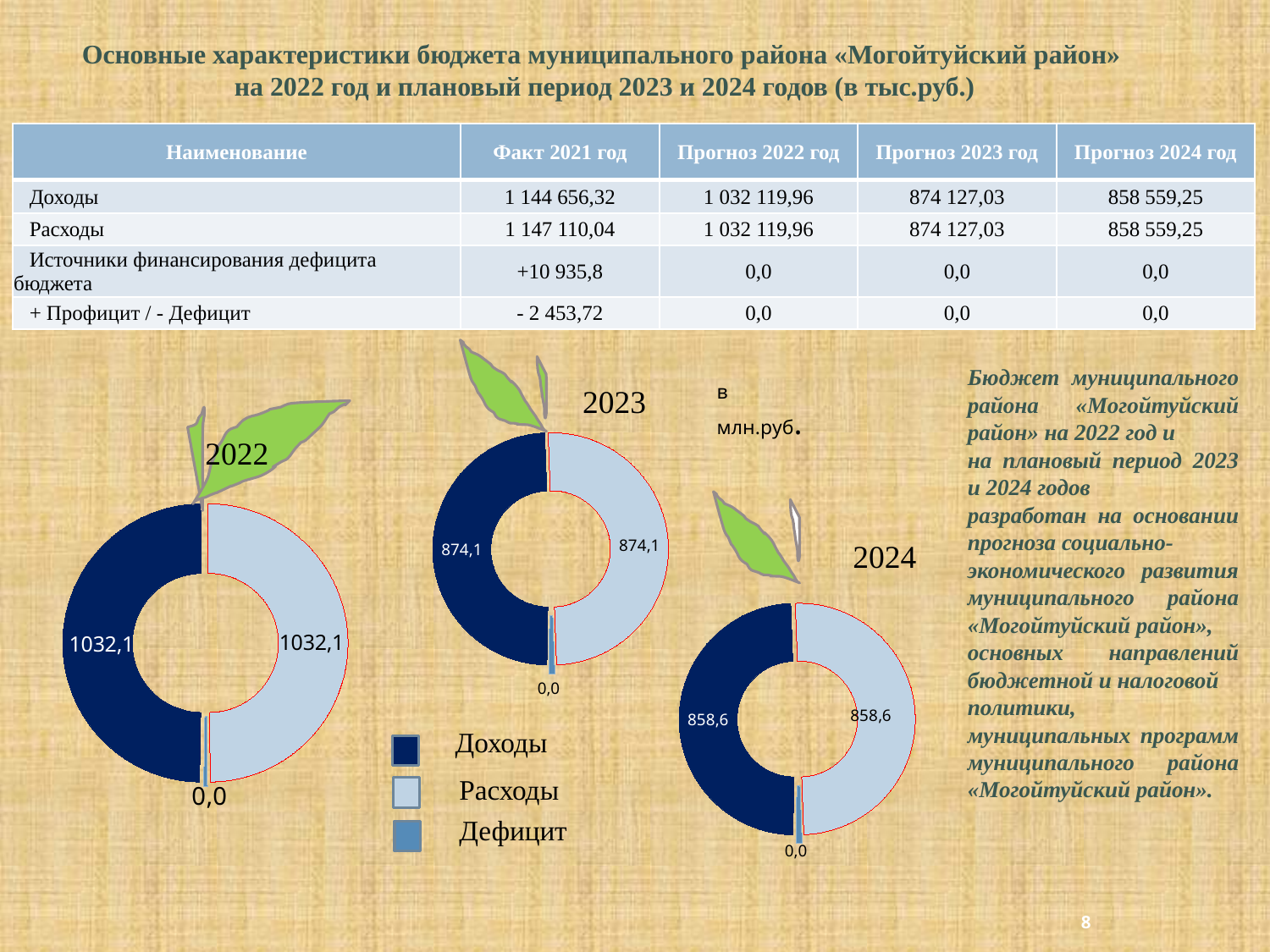
What kind of chart is used for the 2022, 2023 and 2024 budget figures on the slide? Doughnut chart Which legend entry is shown in dark navy blue in the doughnut charts? Доходы Comparing the Доходы values across the 2022, 2023 and 2024 doughnut charts, which year has the highest value? 2022 In the 2023 doughnut chart, what is the value for Доходы? 874,1 How many doughnut charts are shown on the slide? 3 In the 2024 doughnut chart, what is the value for Дефицит? 0,0 In the 2022 doughnut chart, what is the value for Доходы? 1032,1 How many entries does the legend shared by the doughnut charts list? 3 Comparing the Расходы values across the 2022, 2023 and 2024 doughnut charts, which year has the lowest value? 2024 In the 2022 doughnut chart, what is the value for Расходы? 1032,1 In the 2024 doughnut chart, what is the value for Расходы? 858,6 In the 2023 doughnut chart, what is the difference between Доходы and Расходы? 0,0